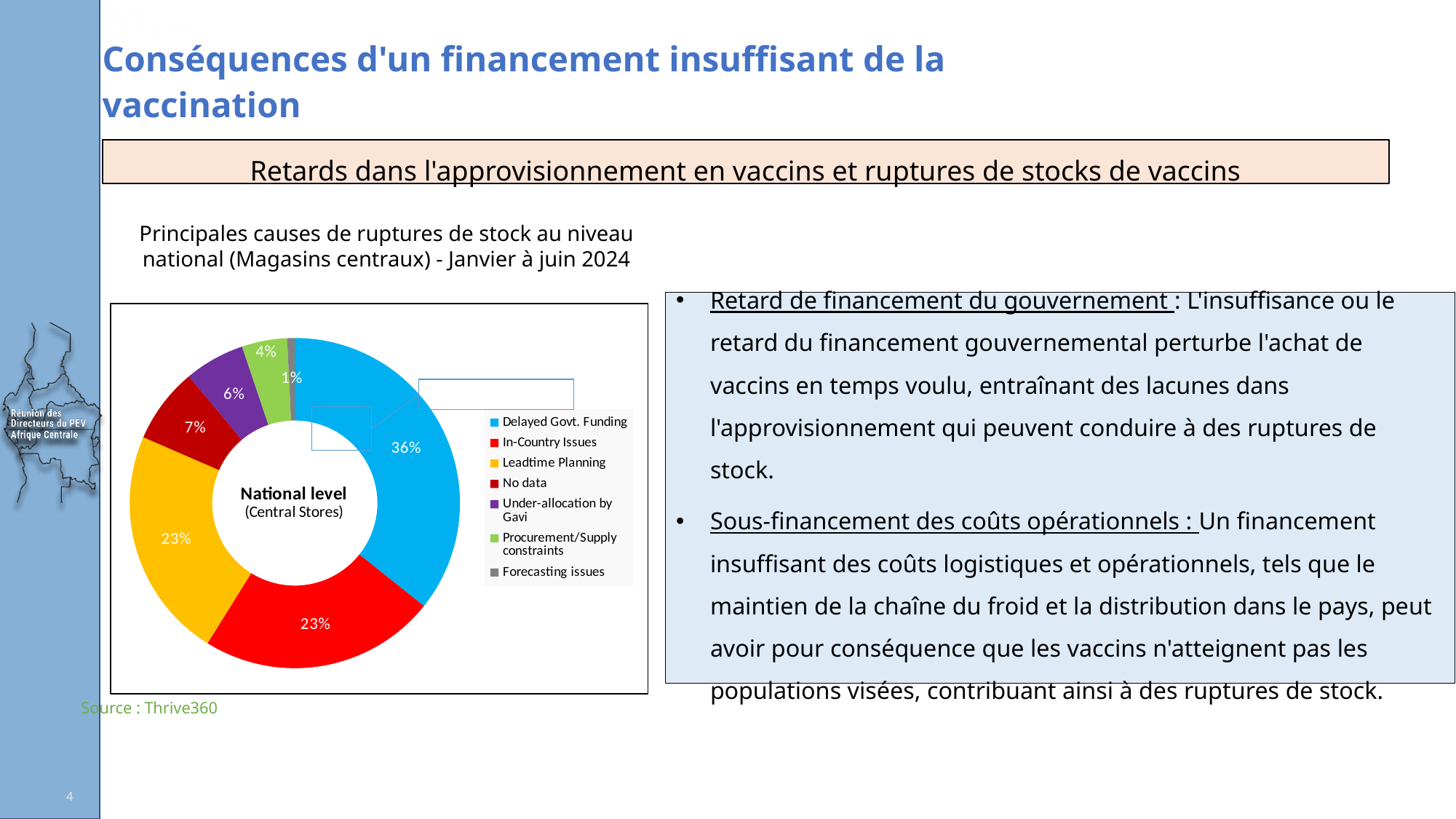
What kind of chart is shown on the slide? Doughnut (pie) chart Which is larger, the share for No data or the share for Under-allocation by Gavi? No data What percentage is shown for Under-allocation by Gavi? 6% How many categories does the legend list? 7 What text is written in the centre of the doughnut chart? National level (Central Stores) What is the difference in percentage points between Delayed Govt. Funding and Leadtime Planning? 13 What percentage is shown for In-Country Issues? 23% What percentage of stock-outs is attributed to Delayed Govt. Funding? 36% Which cause has the largest share of the chart? Delayed Govt. Funding Which cause has the smallest share of the chart? Forecasting issues What percentage is shown for No data? 7% What percentage is shown for Procurement/Supply constraints? 4%